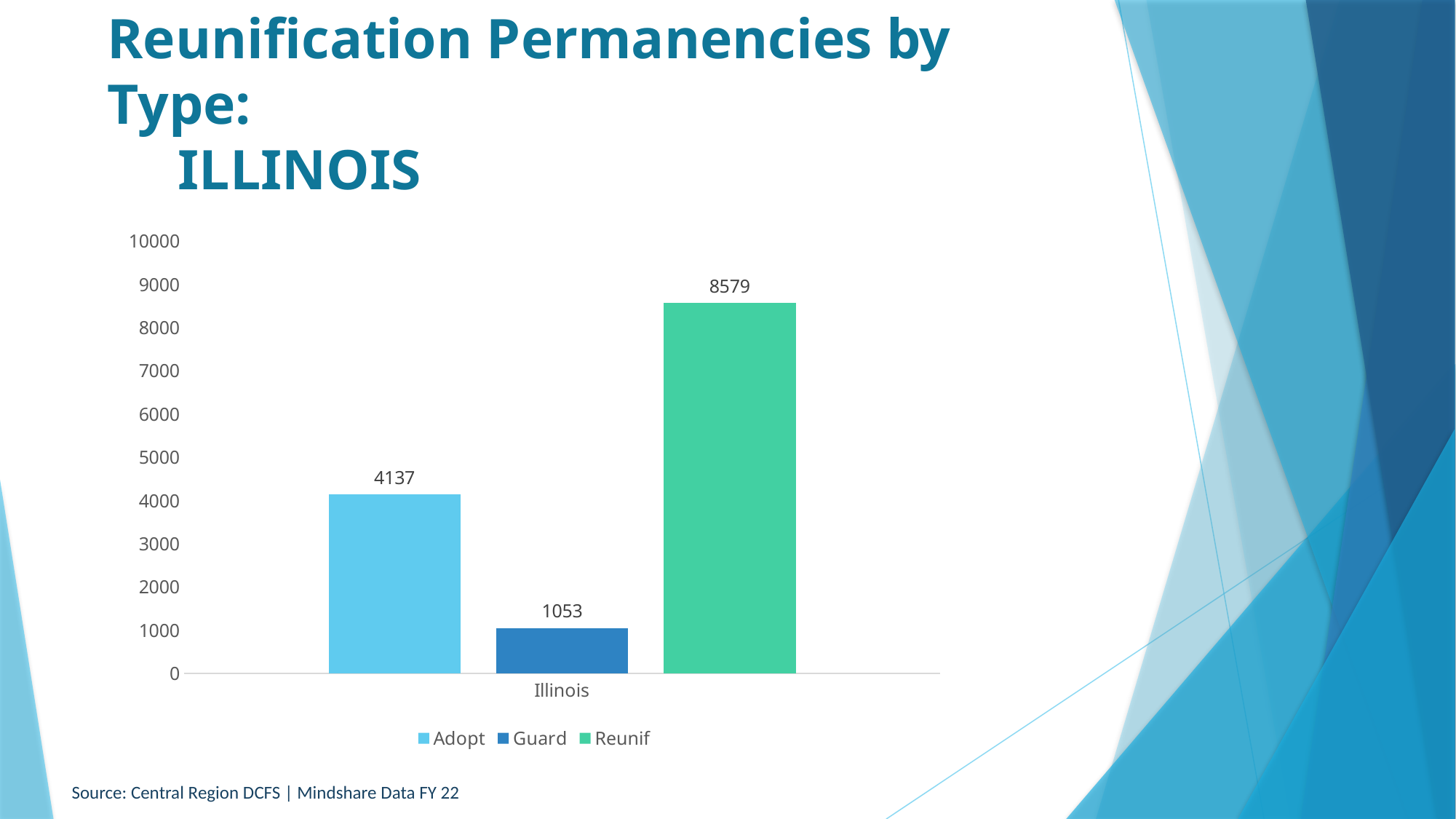
Which series has the lowest value? Guard What is the value for Adopt in Illinois? 4137 What is the difference between the Adopt and Guard values? 3084 Is the value for Reunif greater or less than 8000? greater What is the difference between the Reunif and Adopt values? 4442 Which series has the highest value? Reunif What kind of chart is shown on the slide? bar chart What is the value for Guard in Illinois? 1053 Which is larger, Adopt or Guard? Adopt How many series does the legend list? 3 What is the value for Reunif in Illinois? 8579 What is the category label on the x axis? Illinois